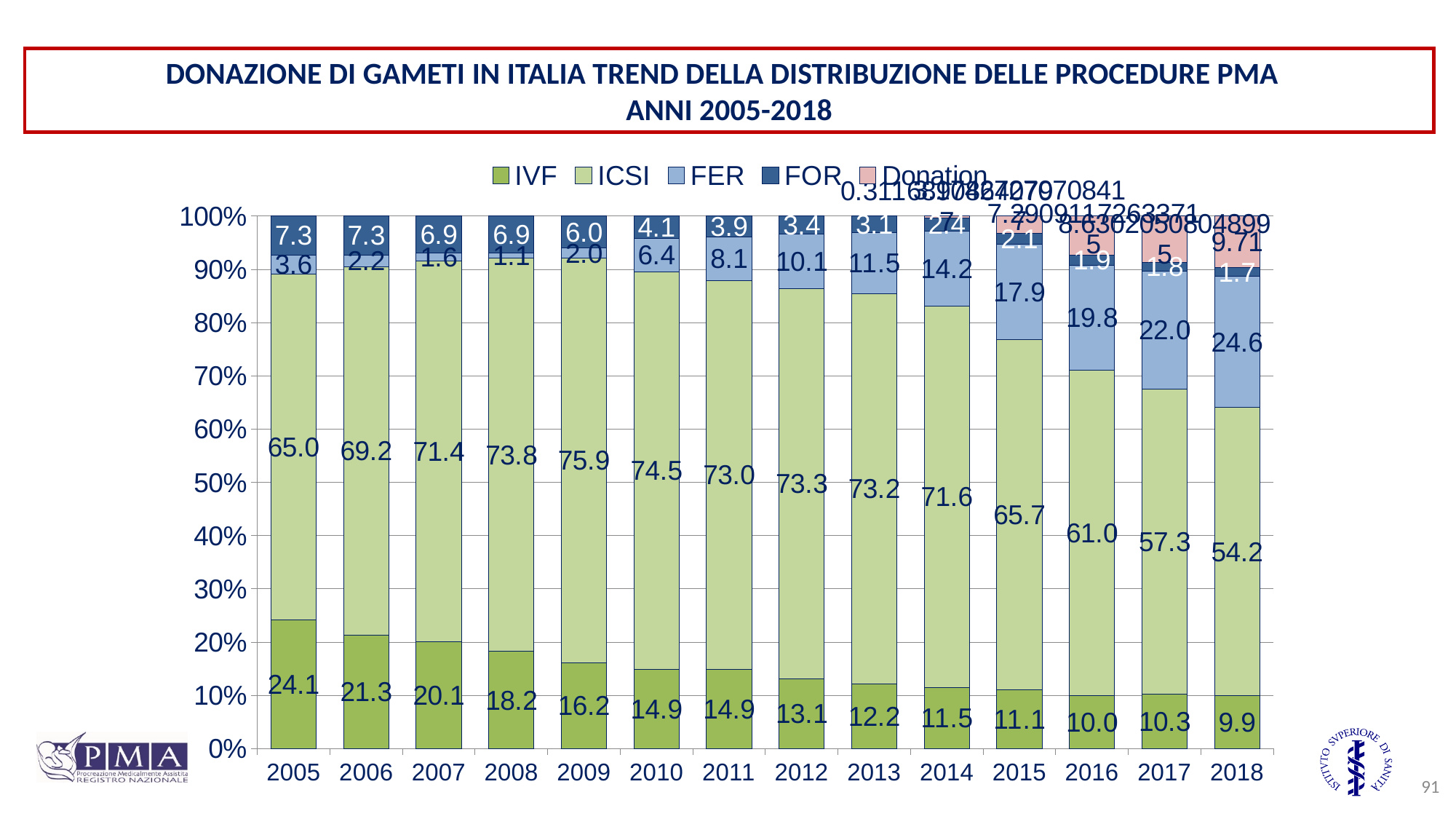
Which year has the larger FER value, 2016 or 2017? 2017 What is the ICSI value for 2009? 75.9 Does the IVF share rise or fall from 2005 to 2018? Fall How many years are shown on the x axis? 14 How many series does the legend list? 5 In which year is the ICSI share highest? 2009 In which year is the IVF share highest? 2005 What is the FOR value for 2005? 7.3 What kind of chart is shown on the slide? Stacked bar chart What is the IVF value for 2005? 24.1 What is the FER value for 2018? 24.6 What is the difference between the ICSI value in 2005 and in 2018? 10.8